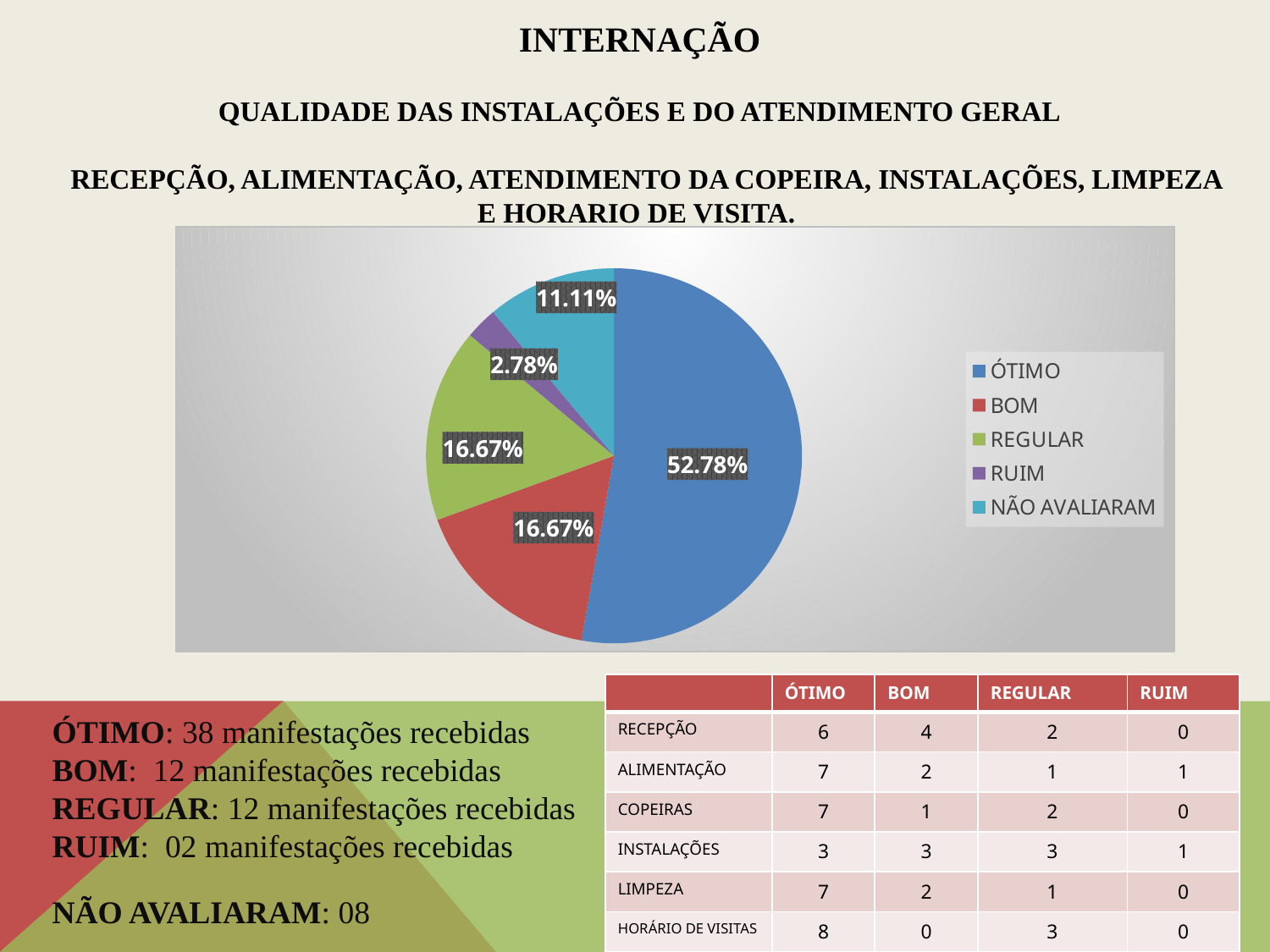
What type of chart is shown on the slide? pie chart What percentage of the pie chart is the BOM slice? 16.67% What is the difference in percentage points between the ÓTIMO slice and the NÃO AVALIARAM slice? 41.67% How many categories does the legend of the pie chart list? 5 What percentage of the pie chart is the REGULAR slice? 16.67% What percentage of the pie chart is the NÃO AVALIARAM slice? 11.11% What colour is the ÓTIMO slice in the pie chart? blue Which category has the largest slice in the pie chart? ÓTIMO Which category has the smallest slice in the pie chart? RUIM What percentage of the pie chart is the ÓTIMO slice? 52.78% What percentage of the pie chart is the RUIM slice? 2.78% Which slice is larger in the pie chart, NÃO AVALIARAM or RUIM? NÃO AVALIARAM